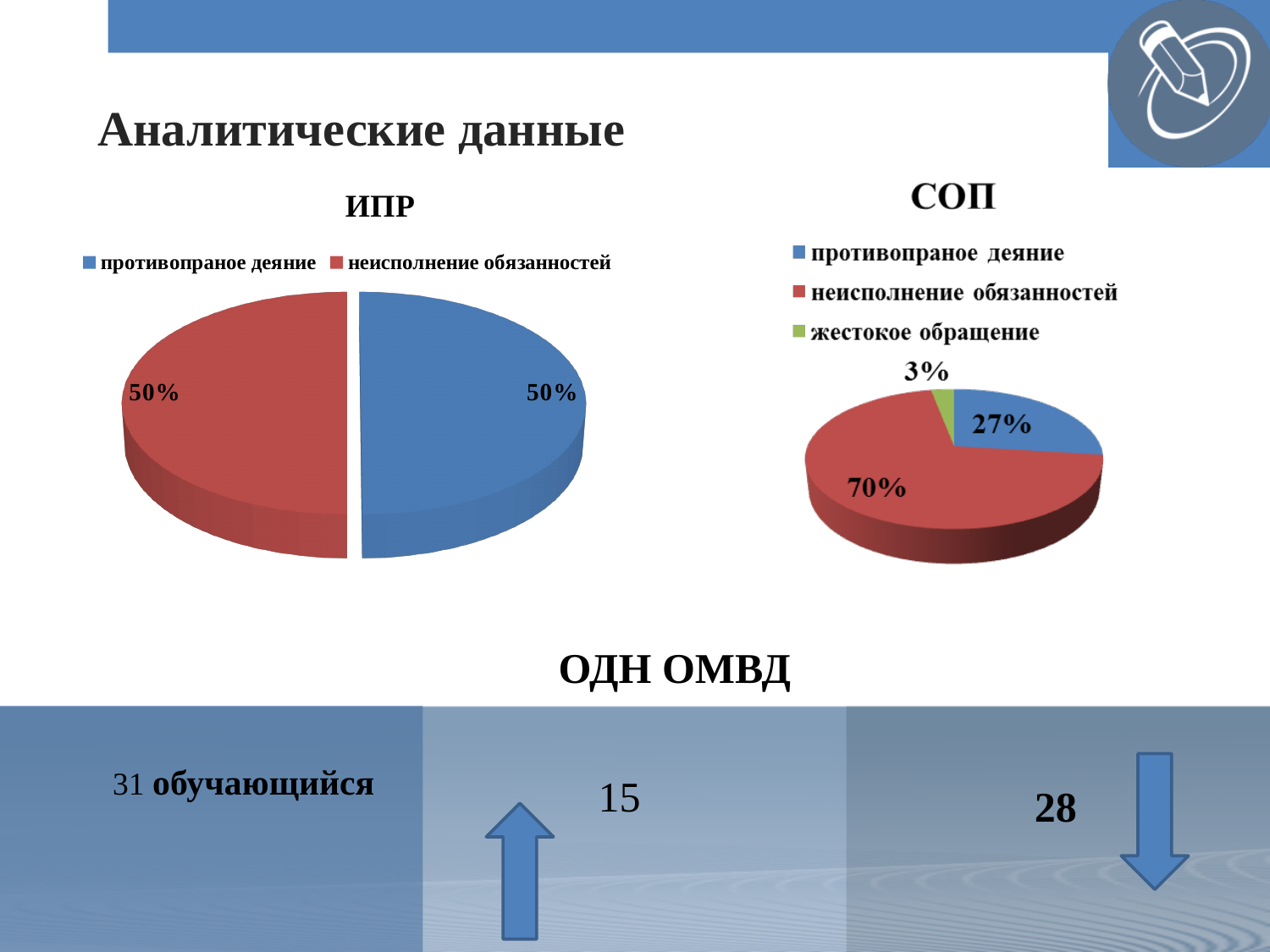
What kind of chart is the "СОП" chart? pie chart In the "СОП" chart, what share does "неисполнение обязанностей" have? 70% In the "ИПР" chart, which colour represents "неисполнение обязанностей"? red In the "ИПР" chart, what share does "противопраное деяние" have? 50% In the "СОП" chart, what share does "противопраное деяние" have? 27% In the "СОП" chart, what is the difference between the shares of "неисполнение обязанностей" and "противопраное деяние"? 43% How many slices does the "ИПР" chart have? 2 What kind of chart is the "ИПР" chart? pie chart In the "СОП" chart, which category has the smallest slice? жестокое обращение How many categories does the legend of the "СОП" chart list? 3 In the "СОП" chart, which category has the largest slice? неисполнение обязанностей